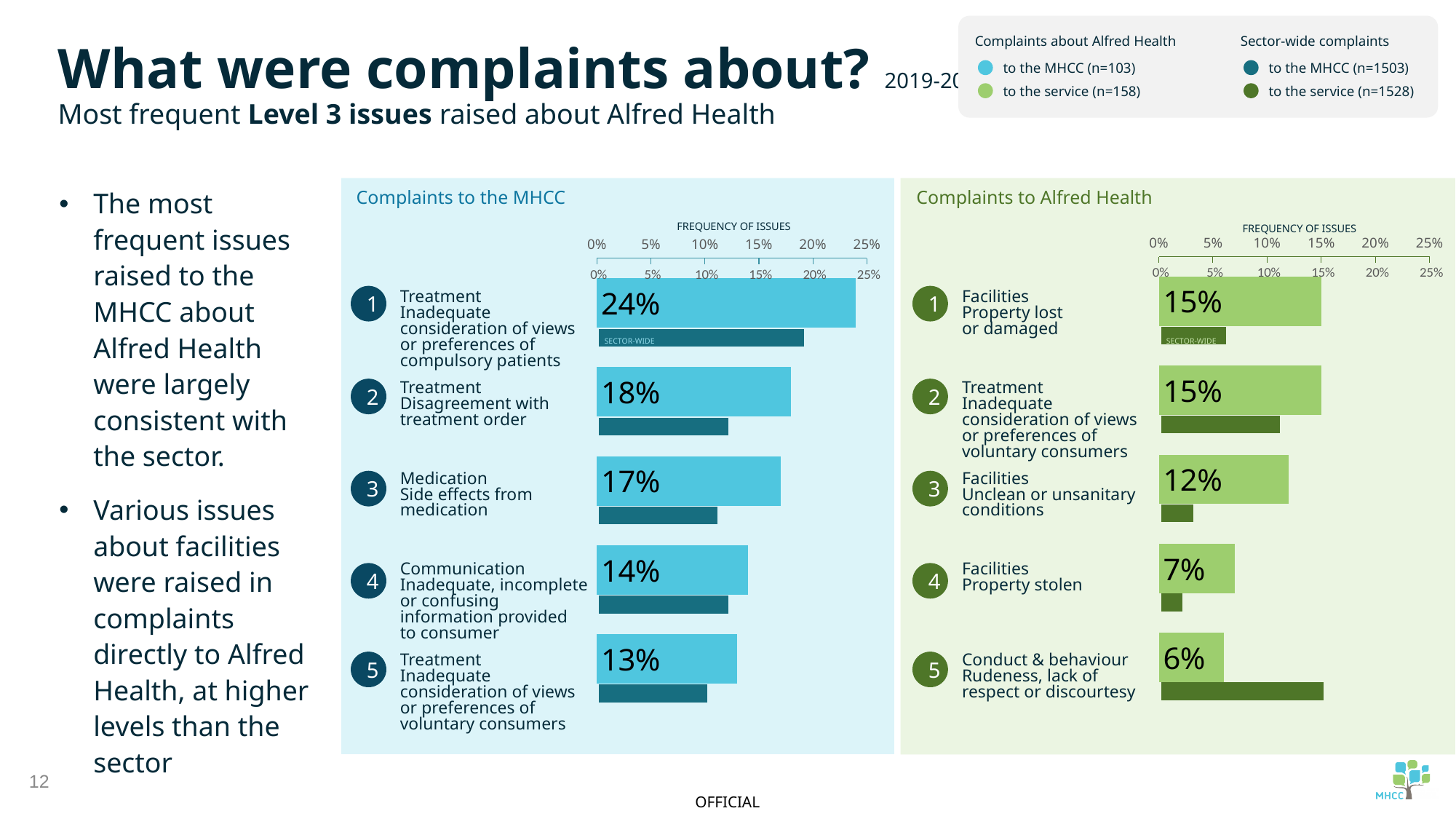
In the 'Complaints to Alfred Health' chart, what is the frequency of issues for 'Conduct & behaviour – Rudeness, lack of respect or discourtesy'? 6% In the 'Complaints to the MHCC' chart, what is the frequency of issues for 'Medication – Side effects from medication'? 17% In the 'Complaints to Alfred Health' chart, is the sector-wide bar for 'Conduct & behaviour – Rudeness, lack of respect or discourtesy' greater or less than 10%? greater What kind of chart is the 'Complaints to the MHCC' chart? Bar chart In the 'Complaints to the MHCC' chart, what is the difference between the frequency for 'Treatment – Disagreement with treatment order' and 'Communication – Inadequate, incomplete or confusing information provided to consumer'? 4% How many issues are listed in the 'Complaints to Alfred Health' chart? 5 In the 'Complaints to the MHCC' chart, what is the frequency of issues for 'Treatment – Inadequate consideration of views or preferences of compulsory patients'? 24% In the 'Complaints to the MHCC' chart, is the sector-wide bar for 'Treatment – Inadequate consideration of views or preferences of compulsory patients' greater or less than 15%? greater In the 'Complaints to Alfred Health' chart, what is the frequency of issues for 'Facilities – Unclean or unsanitary conditions'? 12% In the 'Complaints to Alfred Health' chart, what is the difference between the frequency for 'Facilities – Property lost or damaged' and 'Facilities – Property stolen'? 8% In the 'Complaints to the MHCC' chart, which issue has the highest frequency? Treatment – Inadequate consideration of views or preferences of compulsory patients In the 'Complaints to Alfred Health' chart, which issue has the lowest frequency? Conduct & behaviour – Rudeness, lack of respect or discourtesy